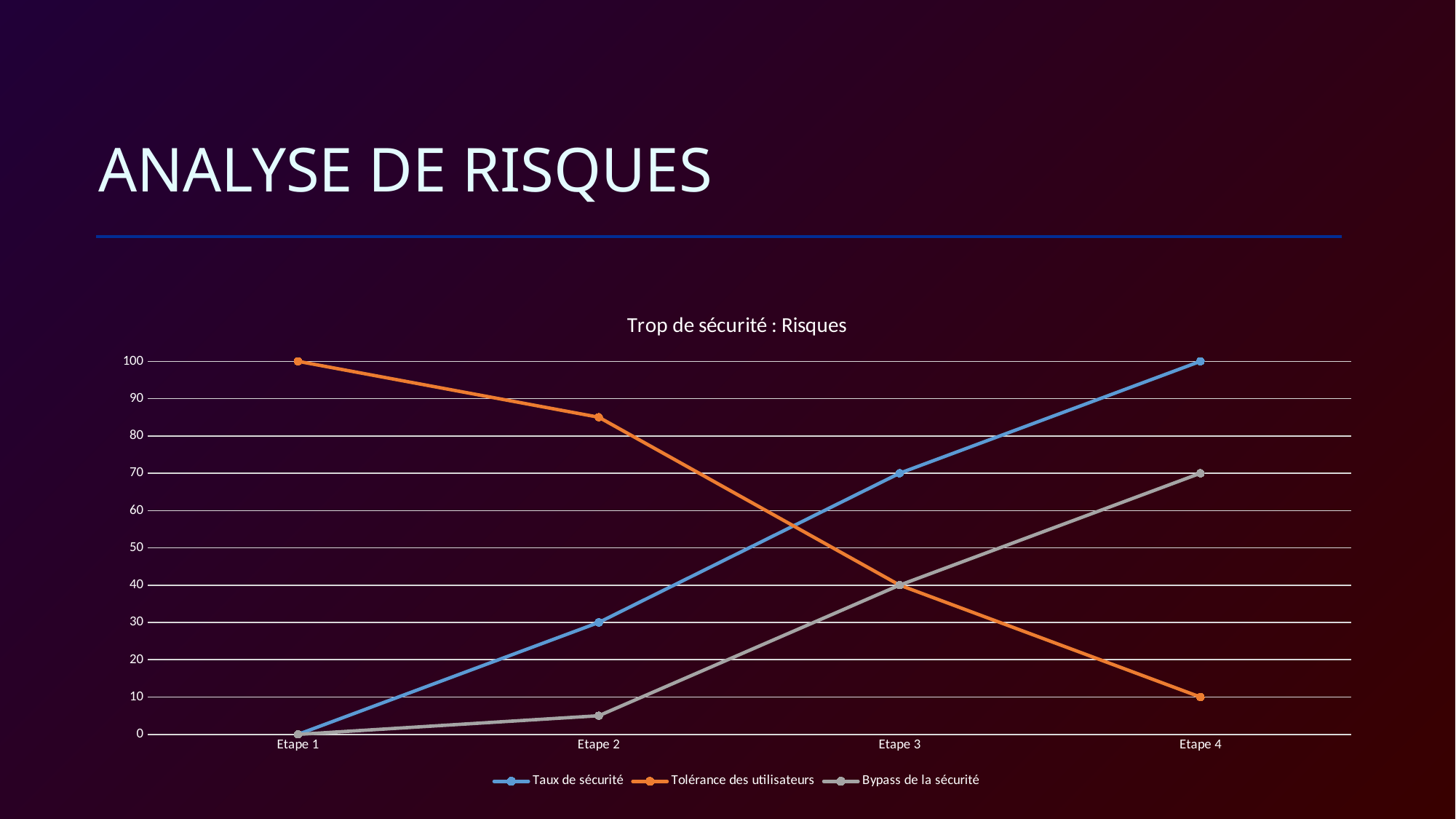
How many series does the legend list? 3 How many stages (Etapes) are shown on the x axis? 4 What type of chart is shown on the slide? line chart What is the value of Bypass de la sécurité at Etape 4? 70 What is the value of Taux de sécurité at Etape 2? 30 What is the value of Tolérance des utilisateurs at Etape 1? 100 Is the value of Bypass de la sécurité at Etape 2 greater or less than 10? less What is the difference between Taux de sécurité and Tolérance des utilisateurs at Etape 4? 90 What is the title of the chart? Trop de sécurité : Risques Is the value of Tolérance des utilisateurs at Etape 2 greater or less than 80? greater What is the value of Taux de sécurité at Etape 4? 100 Does Tolérance des utilisateurs rise or fall from Etape 1 to Etape 4? fall